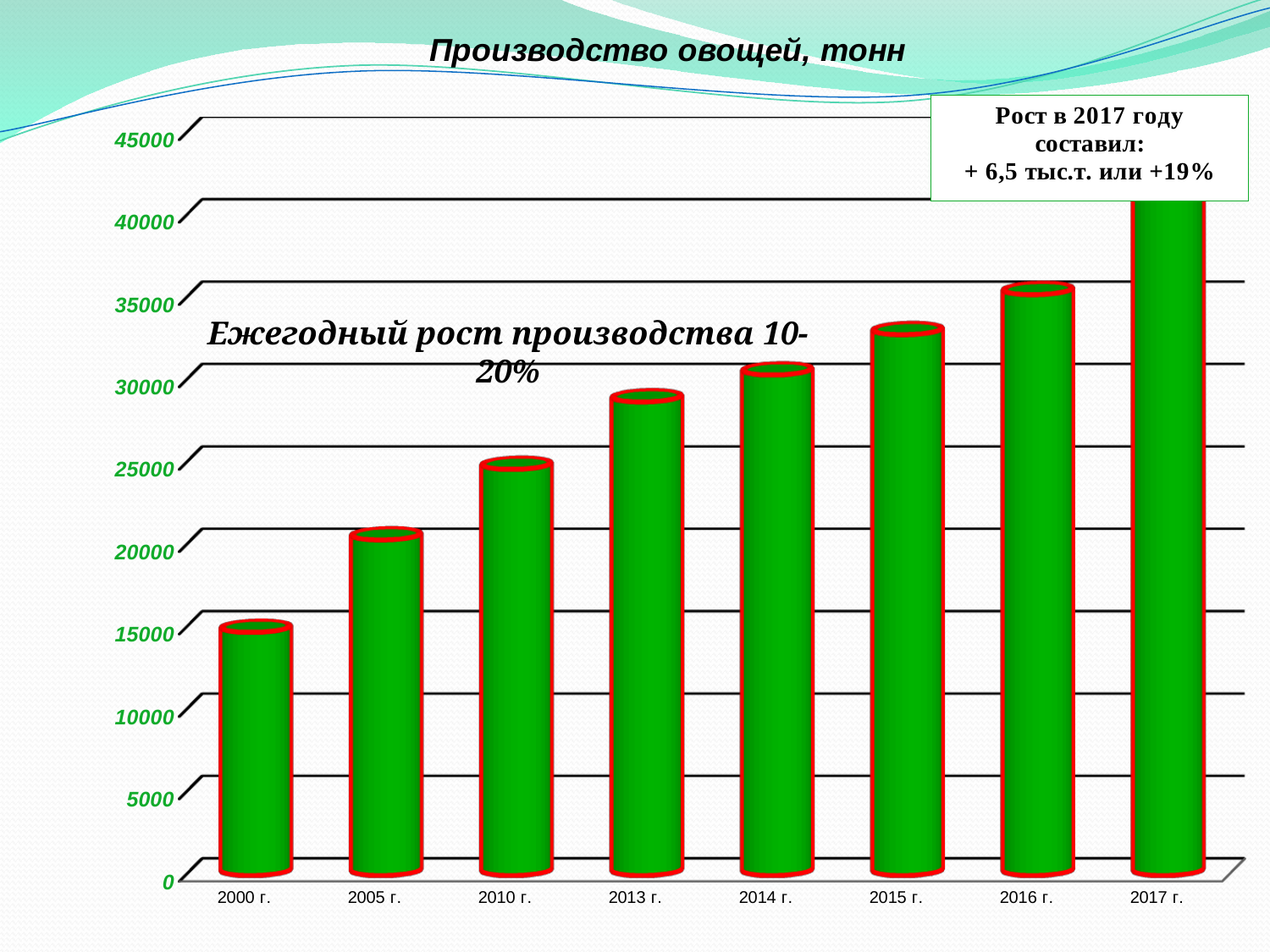
Is the value for 2013 г. greater or less than 25000? greater Which year has the lowest vegetable production? 2000 г. What kind of chart is shown on the slide? bar chart Is the value for 2017 г. greater or less than 40000? greater Is the value for 2015 г. greater or less than 30000? greater Which is larger, the value for 2016 г. or the value for 2010 г.? 2016 г. Do the values rise or fall from 2000 г. to 2017 г. along the x axis? rise What is the title of the chart? Производство овощей, тонн Which year has the highest vegetable production? 2017 г. According to the text box on the chart, by how much did production grow in 2017? + 6,5 тыс.т. или +19% How many years (categories) are plotted on the x axis? 8